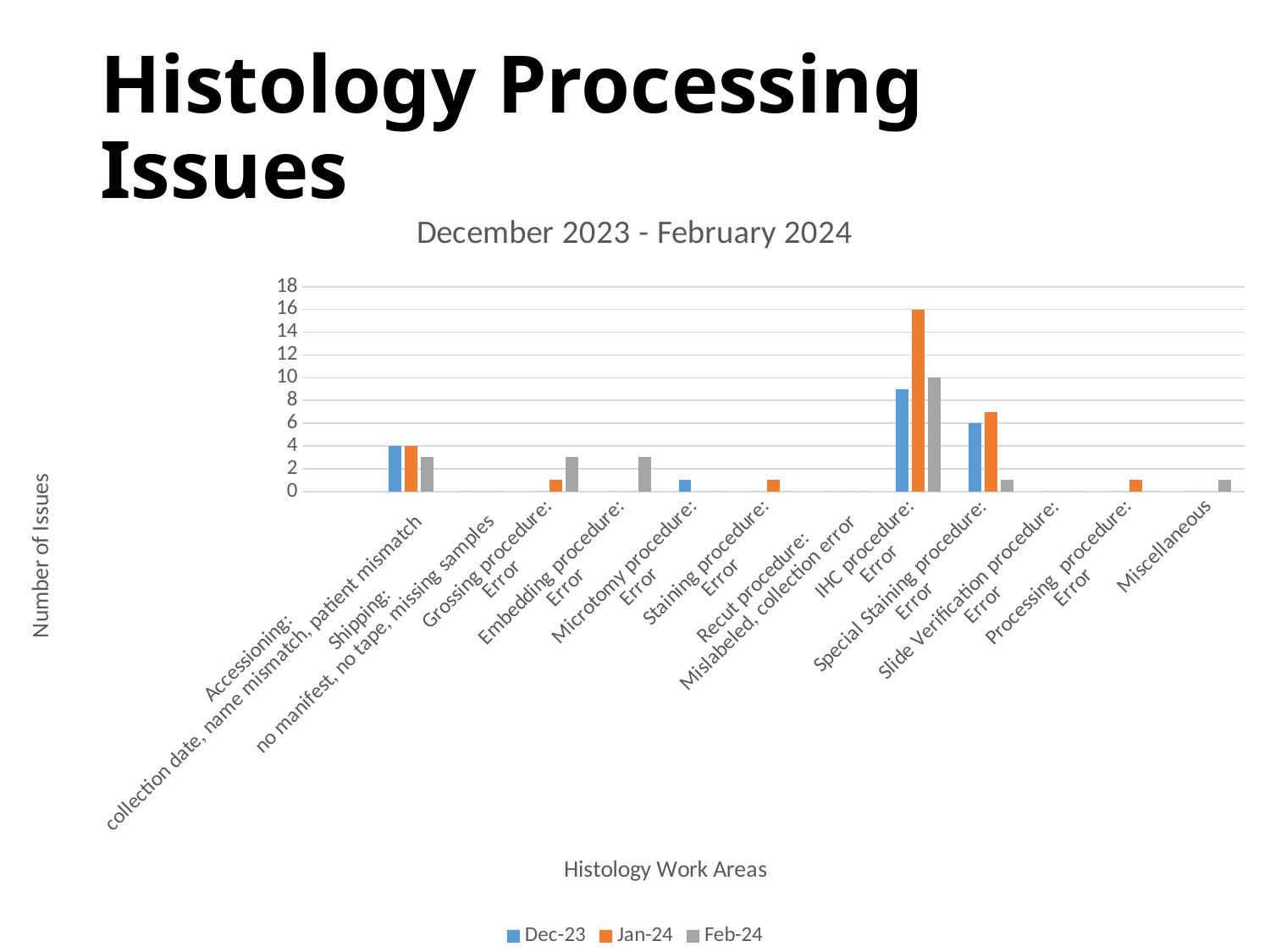
How many histology work area categories are shown on the x axis? 12 For IHC procedure: Error, which is larger, the Jan-24 value or the Feb-24 value? Jan-24 What is the Feb-24 value for IHC procedure: Error? 10 What is the label on the vertical axis of the chart? Number of Issues What is the Jan-24 value for IHC procedure: Error? 16 How many series does the legend list? 3 Is the Feb-24 value for Grossing procedure: Error greater or less than 4? less Which work area has the highest number of issues in any month? IHC procedure: Error What is the Dec-23 value for Accessioning? 4 What kind of chart is shown on the slide? bar chart What is the Dec-23 value for Special Staining procedure: Error? 6 Is the Dec-23 value for IHC procedure: Error greater or less than 8? greater